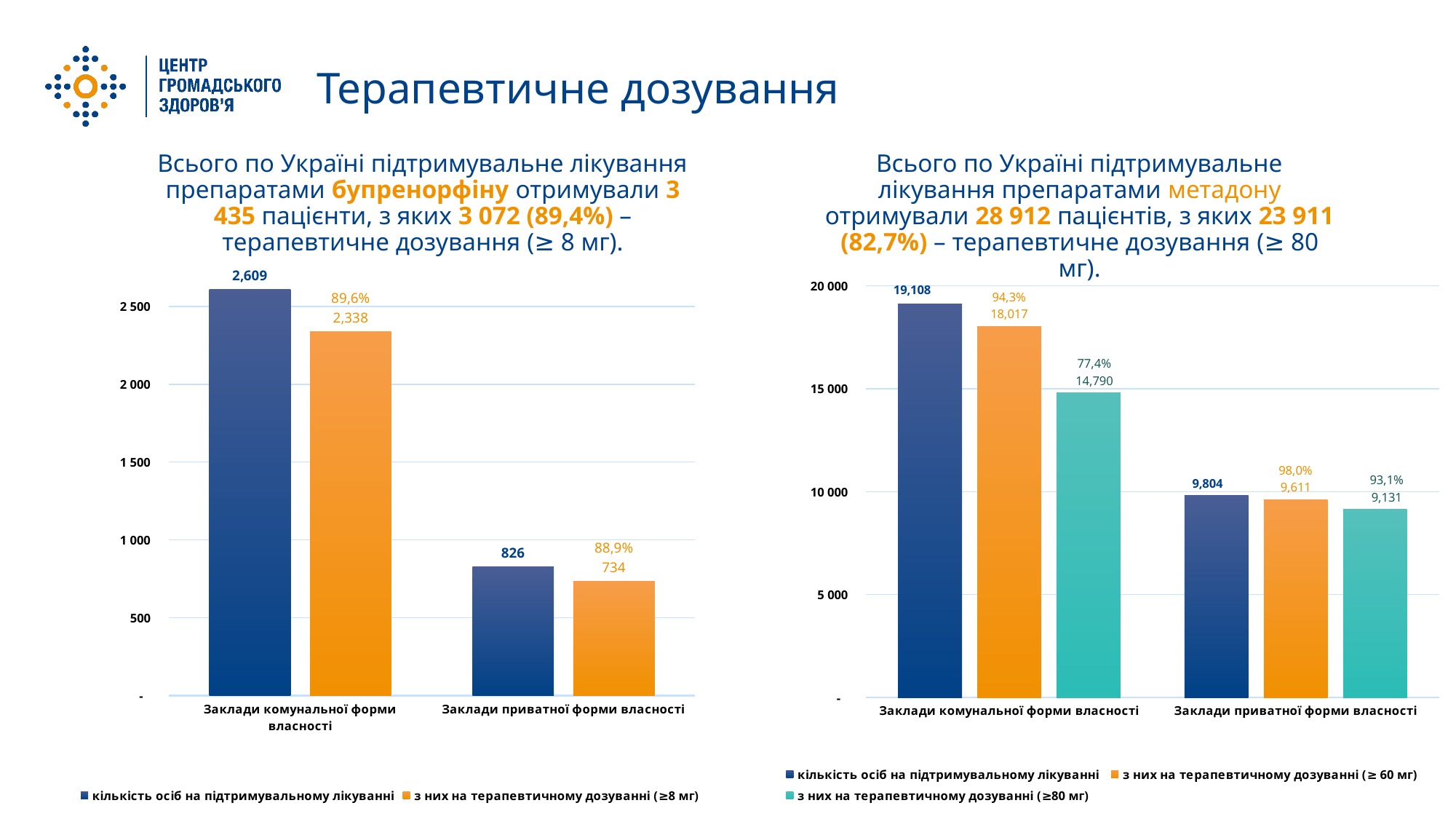
In the right chart (метадон), which category has the highest value for 'кількість осіб на підтримувальному лікуванні'? Заклади комунальної форми власності In the right chart (метадон), what is the value for 'з них на терапевтичному дозуванні (≥80 мг)' at 'Заклади комунальної форми власності'? 14,790 In the left chart (бупренорфін), what is the value for 'кількість осіб на підтримувальному лікуванні' at 'Заклади комунальної форми власності'? 2,609 In the right chart (метадон), what is the difference between the '≥ 60 мг' and '≥80 мг' values for 'Заклади комунальної форми власності'? 3,227 In the right chart (метадон), how many series does the legend list? 3 What type of chart is the right chart (метадон)? Bar chart In the right chart (метадон), what is the value for 'кількість осіб на підтримувальному лікуванні' at 'Заклади приватної форми власності'? 9,804 In the left chart (бупренорфін), what is the value for 'з них на терапевтичному дозуванні (≥8 мг)' at 'Заклади приватної форми власності'? 734 In the left chart (бупренорфін), what is the difference between the 'кількість осіб на підтримувальному лікуванні' values for communal and private facilities? 1,783 In the right chart (метадон), what percentage label is shown above the teal bar for 'Заклади приватної форми власності'? 93,1% In the left chart (бупренорфін), how many series does the legend list? 2 In the left chart (бупренорфін), what percentage label is shown above the orange bar for 'Заклади комунальної форми власності'? 89,6%